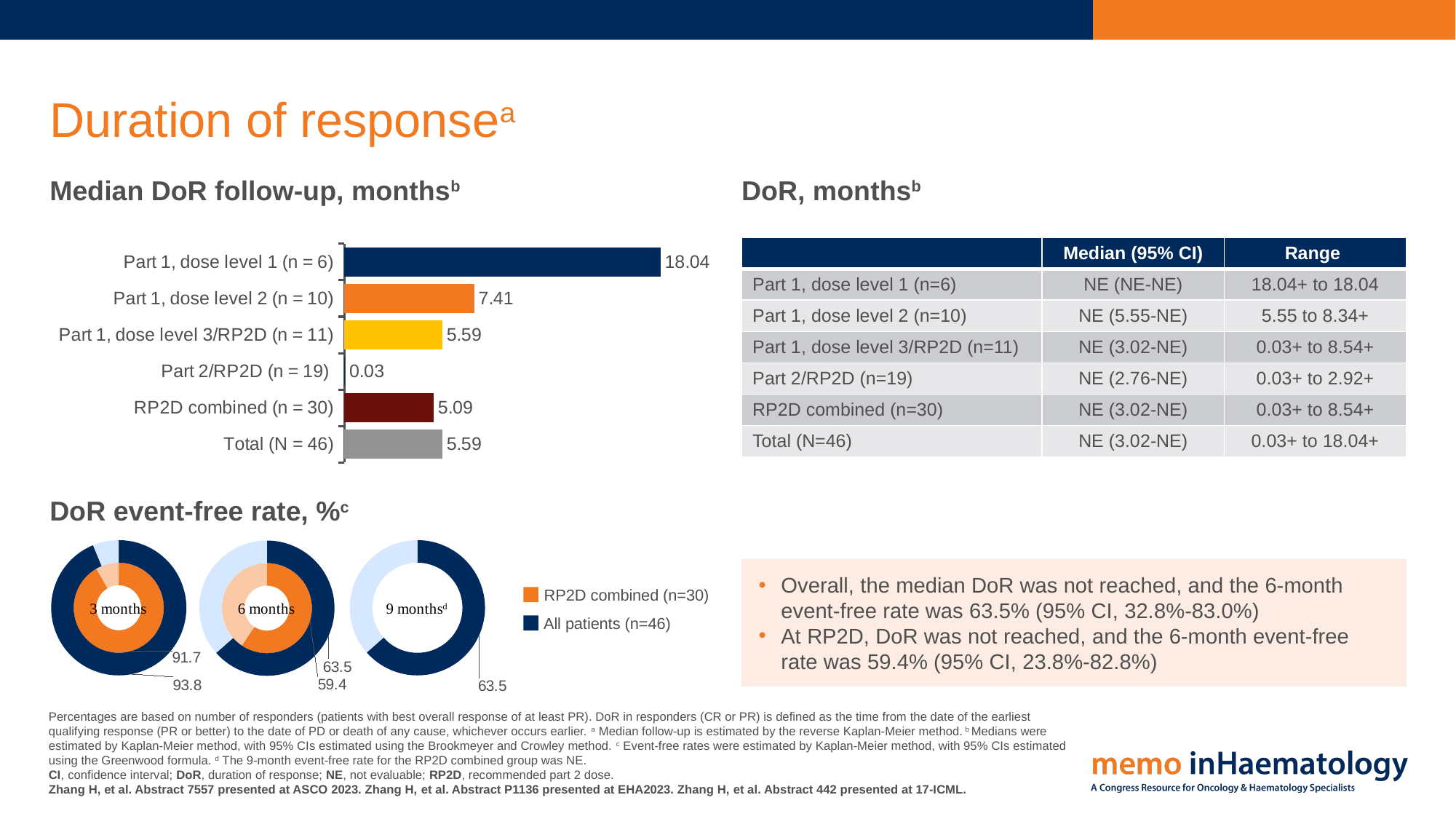
In the 'Median DoR follow-up, months' chart, which category has the lowest value? Part 2/RP2D (n = 19) In the 'DoR event-free rate, %' chart, what is the 3-month event-free rate for All patients (n=46)? 93.8 In the 'DoR event-free rate, %' chart, what is the 6-month event-free rate for RP2D combined (n=30)? 59.4 In the 'Median DoR follow-up, months' chart, which category has the highest value? Part 1, dose level 1 (n = 6) What kind of chart is the 'Median DoR follow-up, months' chart? Bar chart In the 'Median DoR follow-up, months' chart, which is larger: Part 1, dose level 2 or RP2D combined? Part 1, dose level 2 In the 'DoR event-free rate, %' chart, what is the difference between the 3-month rates for All patients and RP2D combined? 2.1 In the 'Median DoR follow-up, months' chart, what is the value for RP2D combined (n = 30)? 5.09 In the 'Median DoR follow-up, months' chart, what is the value for Part 1, dose level 1 (n = 6)? 18.04 In the 'Median DoR follow-up, months' chart, what is the difference between Part 1, dose level 1 and Part 1, dose level 2? 10.63 How many series does the legend of the 'DoR event-free rate, %' chart list? 2 How many categories are shown in the 'Median DoR follow-up, months' bar chart? 6